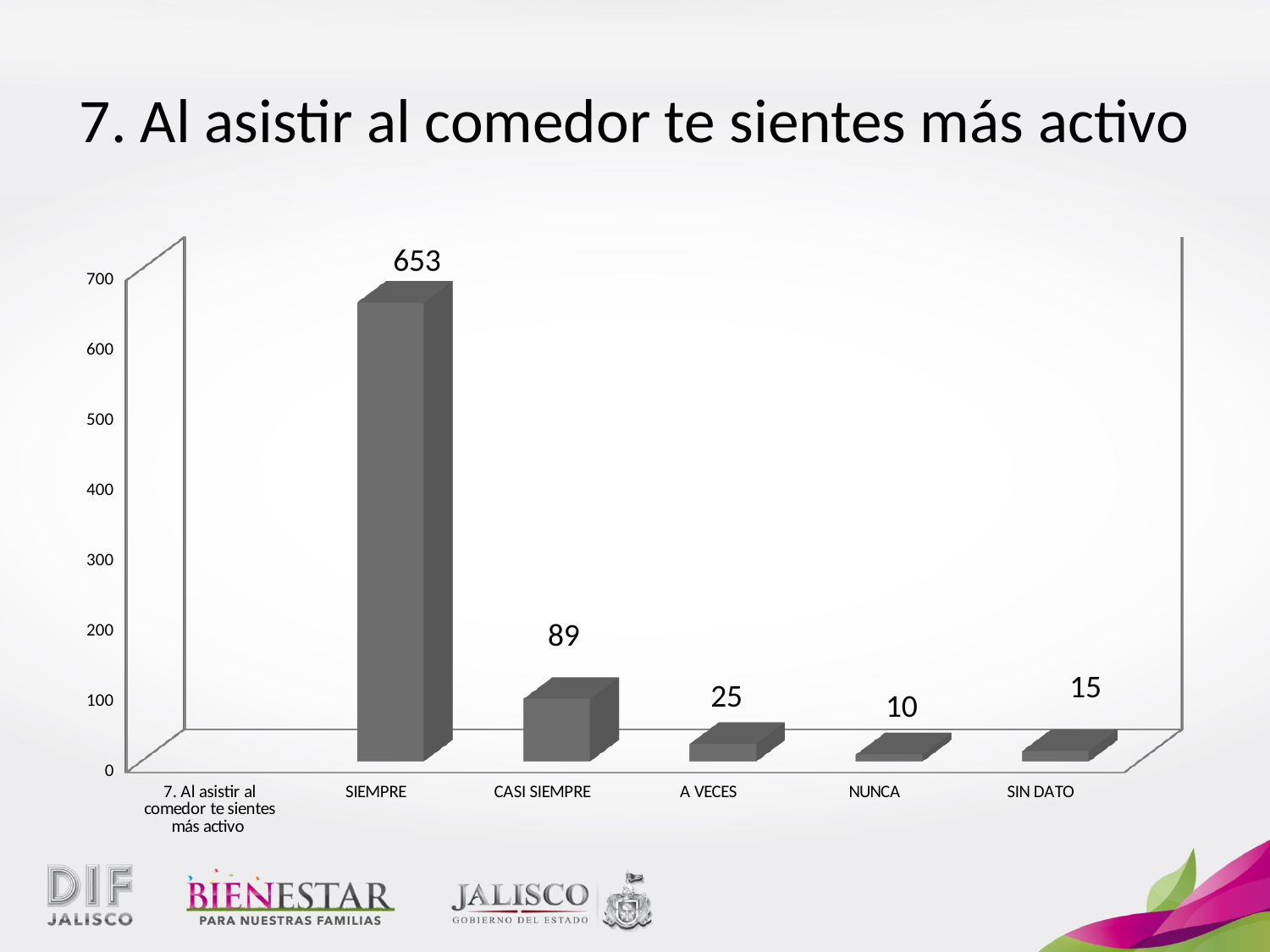
What is the value for NUNCA? 10 Which category has the highest value? SIEMPRE What is the difference between the values for SIEMPRE and CASI SIEMPRE? 564 What is the value for A VECES? 25 Which is larger, the value for SIN DATO or the value for NUNCA? SIN DATO How many bars are plotted in the chart? 5 Is the value for CASI SIEMPRE greater or less than 100? less What is the value for SIEMPRE? 653 What kind of chart is shown on the slide? bar chart Which category has the lowest value? NUNCA What is the value for SIN DATO? 15 What is the value for CASI SIEMPRE? 89